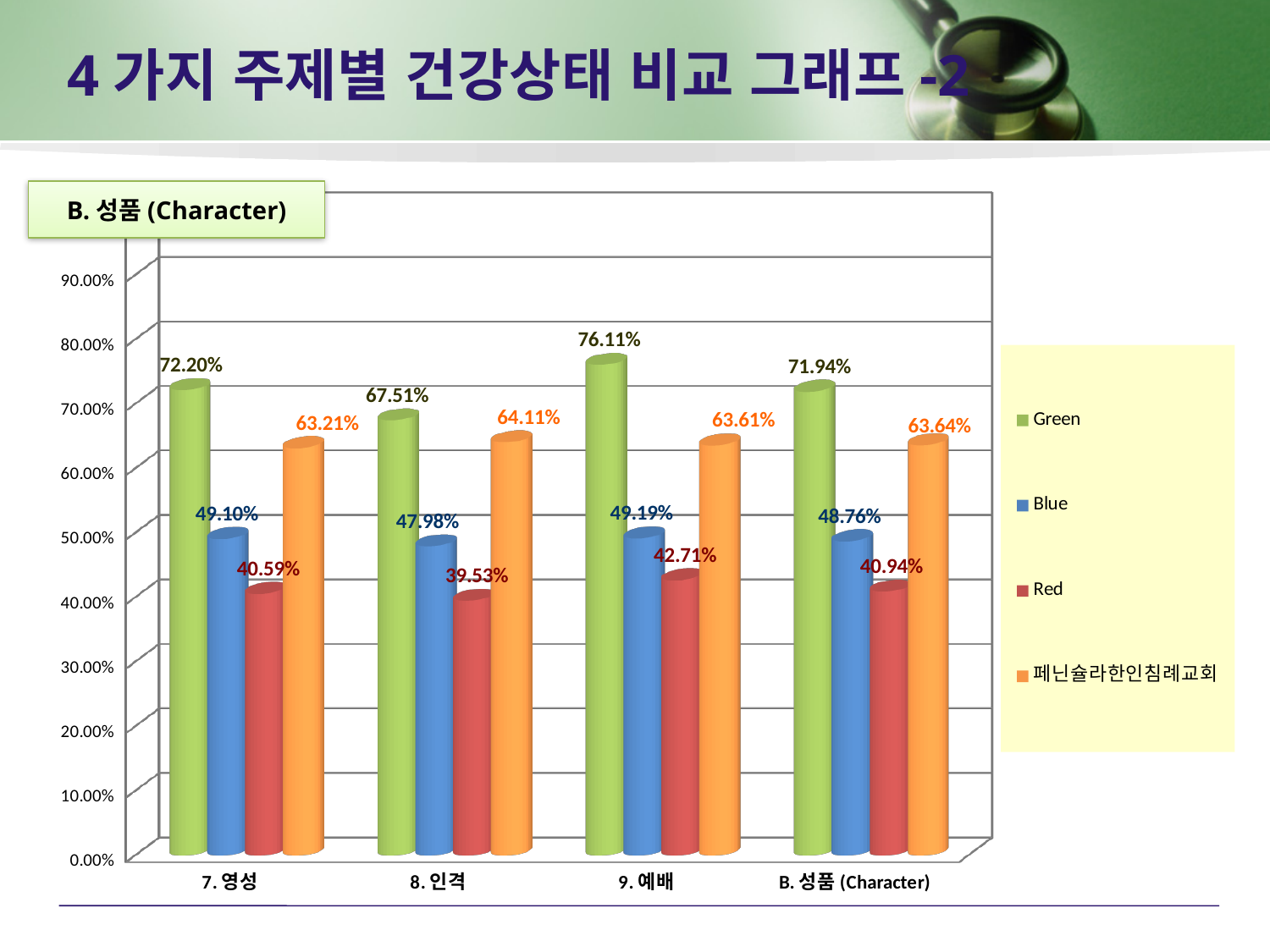
How many categories are shown on the x axis? 4 Which is larger for 8. 인격: the Blue value or the 페닌슐라한인침례교회 value? 페닌슐라한인침례교회 What is the difference between the Green and Red values for 7. 영성? 31.61% Which category has the lowest Red value? 8. 인격 What is the label in the box at the top left of the chart? B. 성품 (Character) What is the Blue value for 8. 인격? 47.98% What kind of chart is shown on the slide? Bar chart How many series does the legend list? 4 What is the 페닌슐라한인침례교회 value for B. 성품 (Character)? 63.64% What is the Green value for 7. 영성? 72.20% Which category has the highest Green value? 9. 예배 What is the Red value for 9. 예배? 42.71%